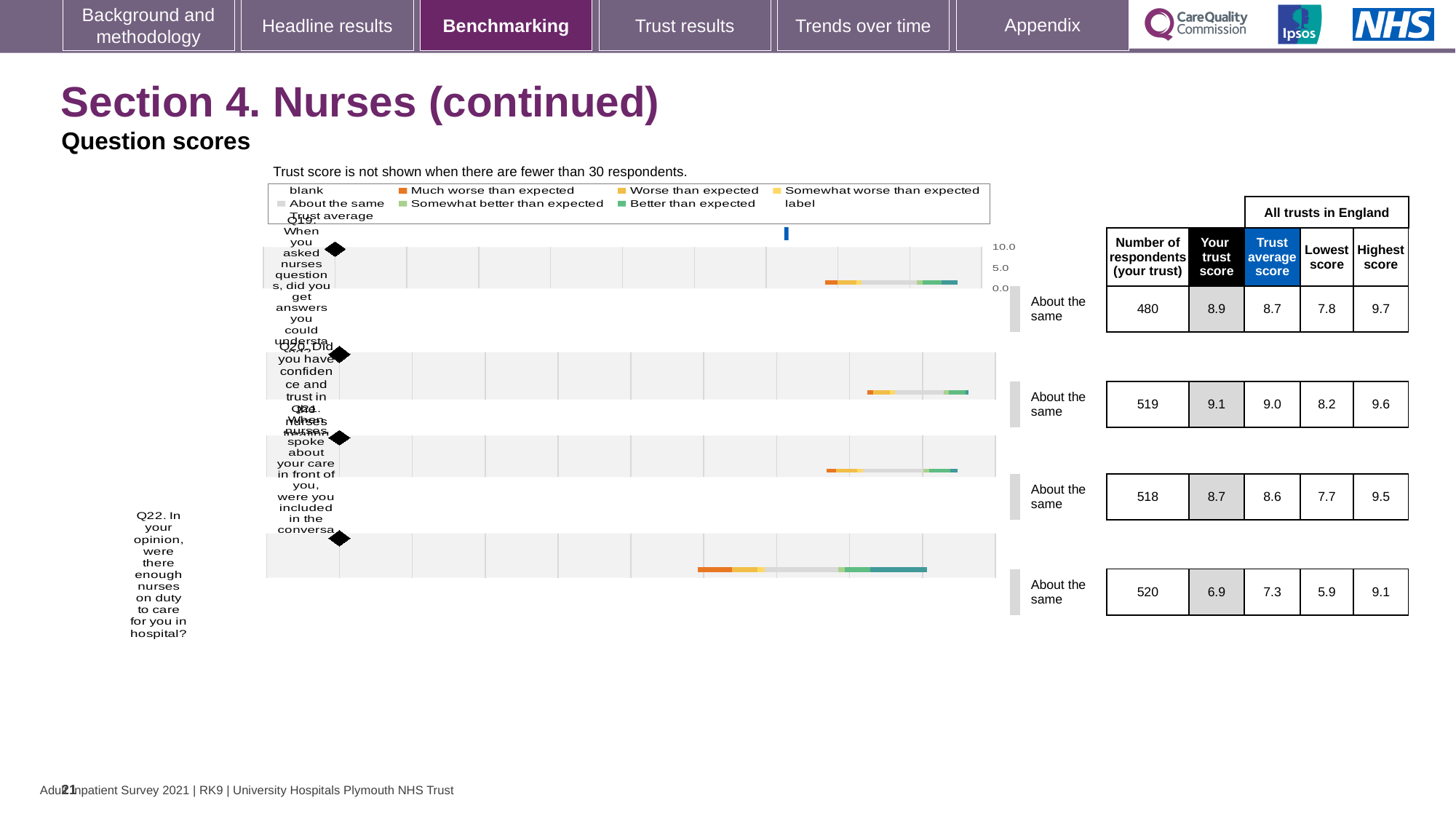
What is the trust average score for Q19 (answers you could understand)? 8.7 Which is larger, this trust's score for Q19 or for Q21? Q19 What kind of chart is used to show the question scores on this slide? bar chart Which question has the lowest 'Your trust score'? Q22 What is the trust score for Q22 (enough nurses on duty) according to the table? 6.9 What is the difference between the trust average score and this trust's score for Q22? 0.4 What is the highest score across all trusts in England for Q21? 9.5 What benchmark category is shown for all four questions on this slide? About the same Is this trust's score for Q22 greater or less than 5.0 on the chart axis? greater How many respondents answered Q20 (confidence and trust in nurses) at this trust? 519 How many questions (categories) are plotted in the chart? 4 Which question has the highest 'Your trust score'? Q20